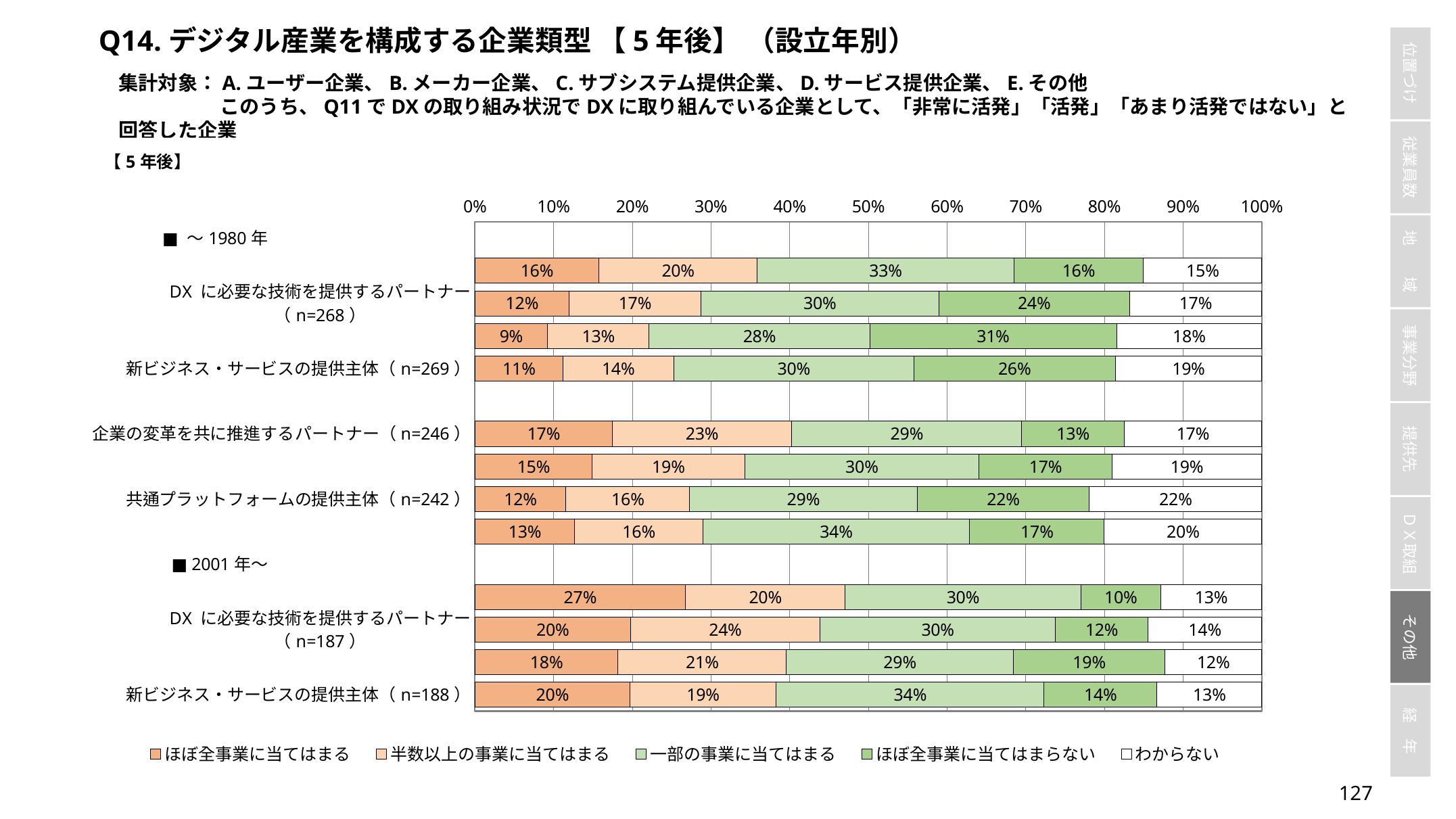
For 共通プラットフォームの提供主体 (n=242), what is the value for わからない? 22% For 新ビジネス・サービスの提供主体 (n=188), what is the value for 一部の事業に当てはまる? 34% For 企業の変革を共に推進するパートナー (n=246), what is the difference between 一部の事業に当てはまる and ほぼ全事業に当てはまらない? 16 percentage points For 共通プラットフォームの提供主体 (n=242), which response category has the largest share? 一部の事業に当てはまる How many stacked bars are plotted in the chart? 12 How many series does the legend list? 5 What kind of chart is shown on the slide? Stacked bar chart Which has the larger value for ほぼ全事業に当てはまる: 新ビジネス・サービスの提供主体 (n=269) or 新ビジネス・サービスの提供主体 (n=188)? 新ビジネス・サービスの提供主体 (n=188) For 新ビジネス・サービスの提供主体 (n=269), what is the value for ほぼ全事業に当てはまる? 11% In the bar directly below the ■ 2001年～ heading, what is the value for ほぼ全事業に当てはまる? 27% For 企業の変革を共に推進するパートナー (n=246), what is the value for 半数以上の事業に当てはまる? 23% What is the first entry listed in the legend? ほぼ全事業に当てはまる